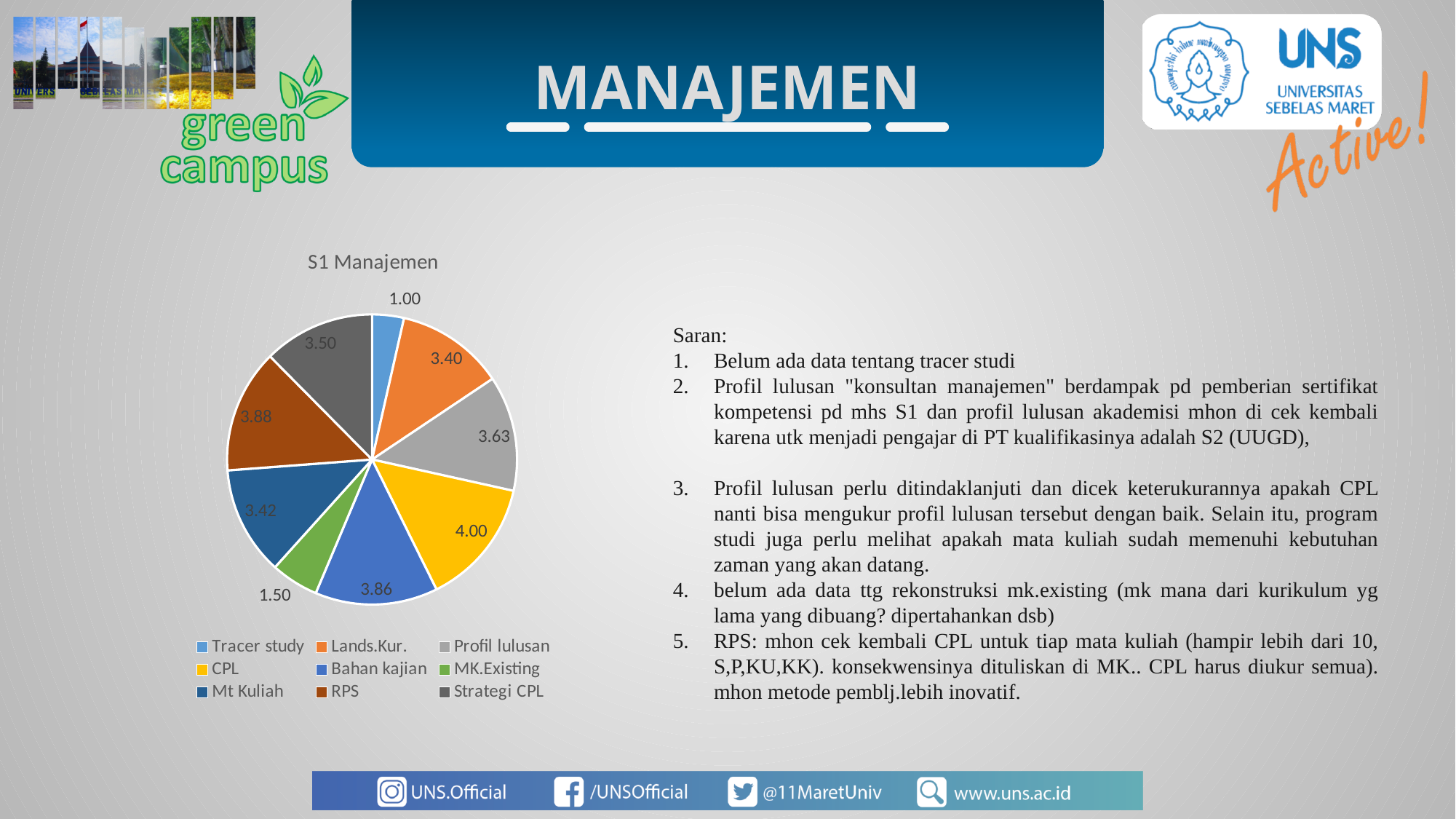
Which has a larger value, Profil lulusan or Strategi CPL? Profil lulusan Which category has the lowest value in the pie chart? Tracer study What is the value for Tracer study in the pie chart? 1.00 What is the value for RPS in the pie chart? 3.88 What is the title of the chart? S1 Manajemen What type of chart is shown on the slide? pie chart How many slices does the pie chart have? 9 What is the value for MK.Existing in the pie chart? 1.50 What colour is the CPL slice in the pie chart? yellow What is the difference between the values for CPL and Tracer study? 3.00 What is the value for CPL in the pie chart? 4.00 Which category has the highest value in the pie chart? CPL